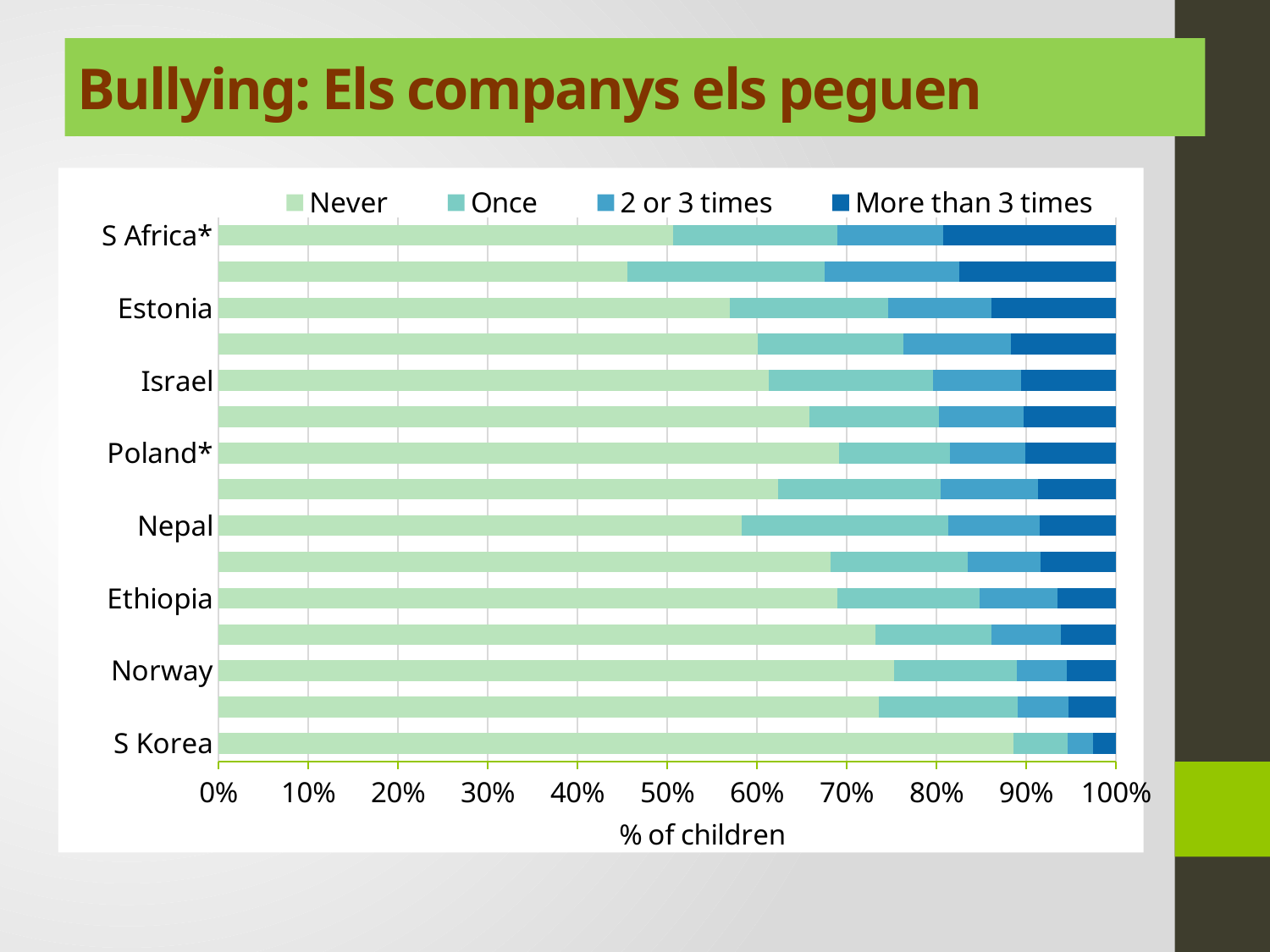
Among the labelled countries, which has the lowest 'Never' share? S Africa* What is the title of the horizontal axis? % of children What kind of chart is shown on the slide? Stacked bar chart Is the 'More than 3 times' value for S Korea greater or less than 10%? less How many series does the legend list? 4 Is the 'Never' value for Norway greater or less than 70%? greater Is the 'Never' value for S Korea greater or less than 80%? greater Among the labelled countries, which has the highest 'Never' share? S Korea How many bars are plotted in the chart? 15 Which has a larger 'Never' share, Norway or Estonia? Norway